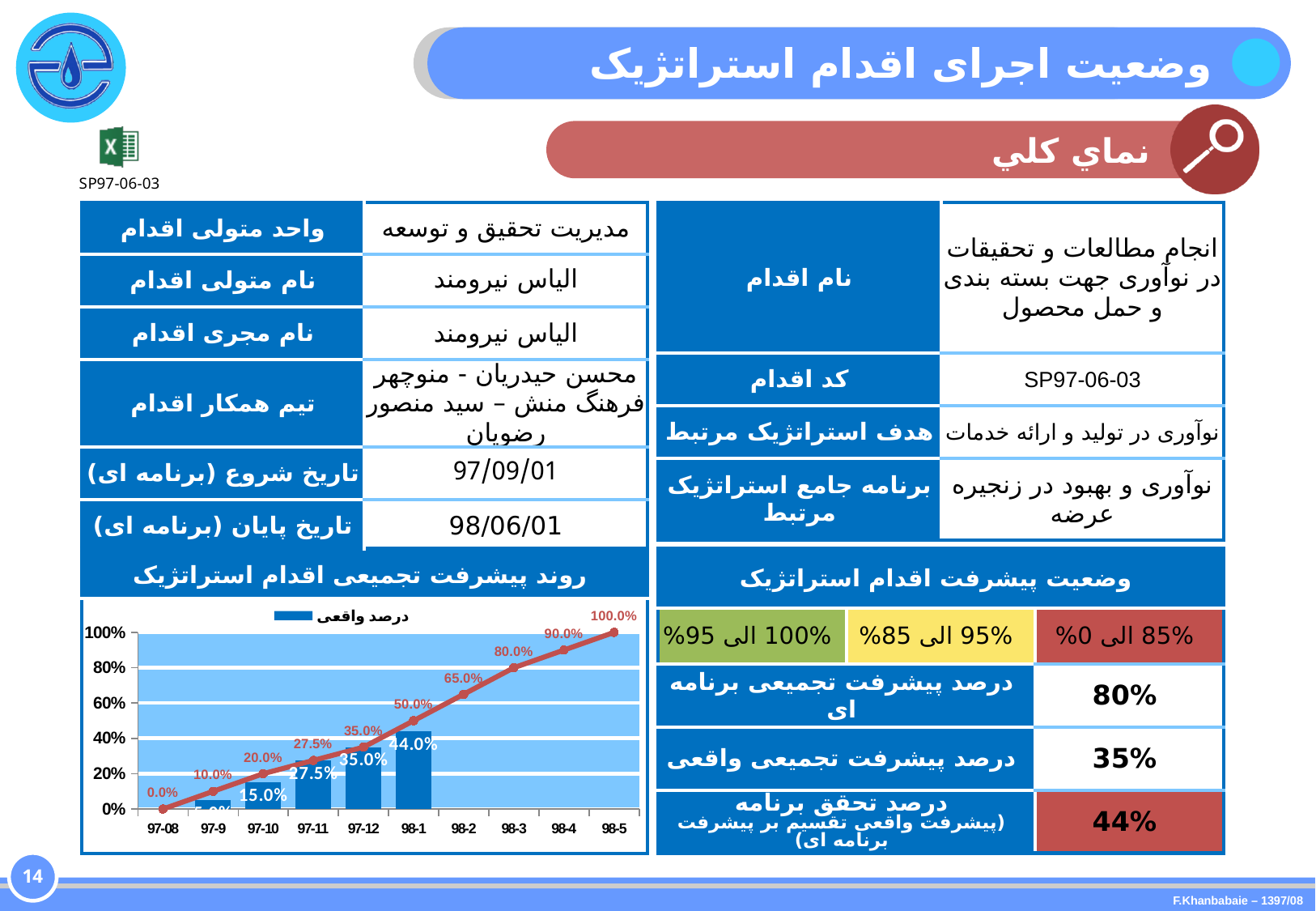
What is the value of the bar (درصد واقعی) at 97-12? 35.0% What is the value of the bar (درصد واقعی) at 98-1? 44.0% What kind of chart is shown on the slide? bar chart with a line Does the line series rise or fall from 97-08 to 98-5? rise What is the value of the line series at 97-11? 27.5% Which is larger at 98-1: the line value or the bar value? the line value At 98-1, what is the difference between the line value and the bar value? 6.0% At which x-axis category does the line series reach its highest value? 98-5 Is the bar value at 97-10 greater or less than 20%? less What is the value of the line series at 98-2? 65.0% How many categories are shown on the x axis of the chart? 10 What is the difference between the line values at 98-5 and 98-4? 10.0%